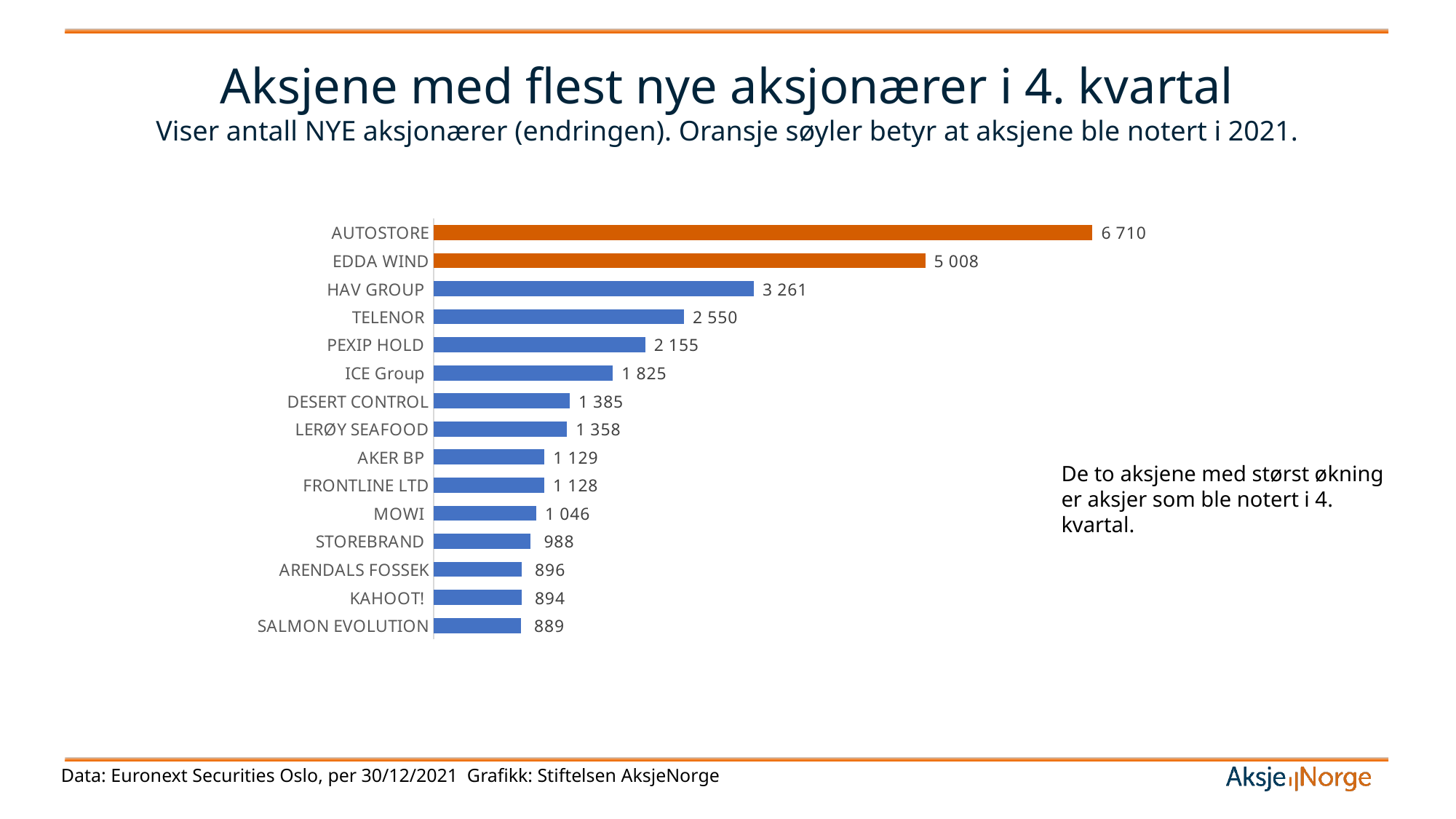
What is the value shown for MOWI? 1 046 What is the value shown for KAHOOT!? 894 Which has a larger value, PEXIP HOLD or ICE Group? PEXIP HOLD What is the difference between the values for AUTOSTORE and EDDA WIND? 1 702 How many stocks are listed in the chart? 15 Which stock has the highest number of new shareholders in the chart? AUTOSTORE Which stock has the lowest value in the chart? SALMON EVOLUTION What type of chart is shown on the slide? bar chart How many new shareholders did AUTOSTORE gain according to the chart? 6 710 How many bars in the chart are orange? 2 What is the difference between the values for HAV GROUP and TELENOR? 711 What is the value shown for TELENOR? 2 550